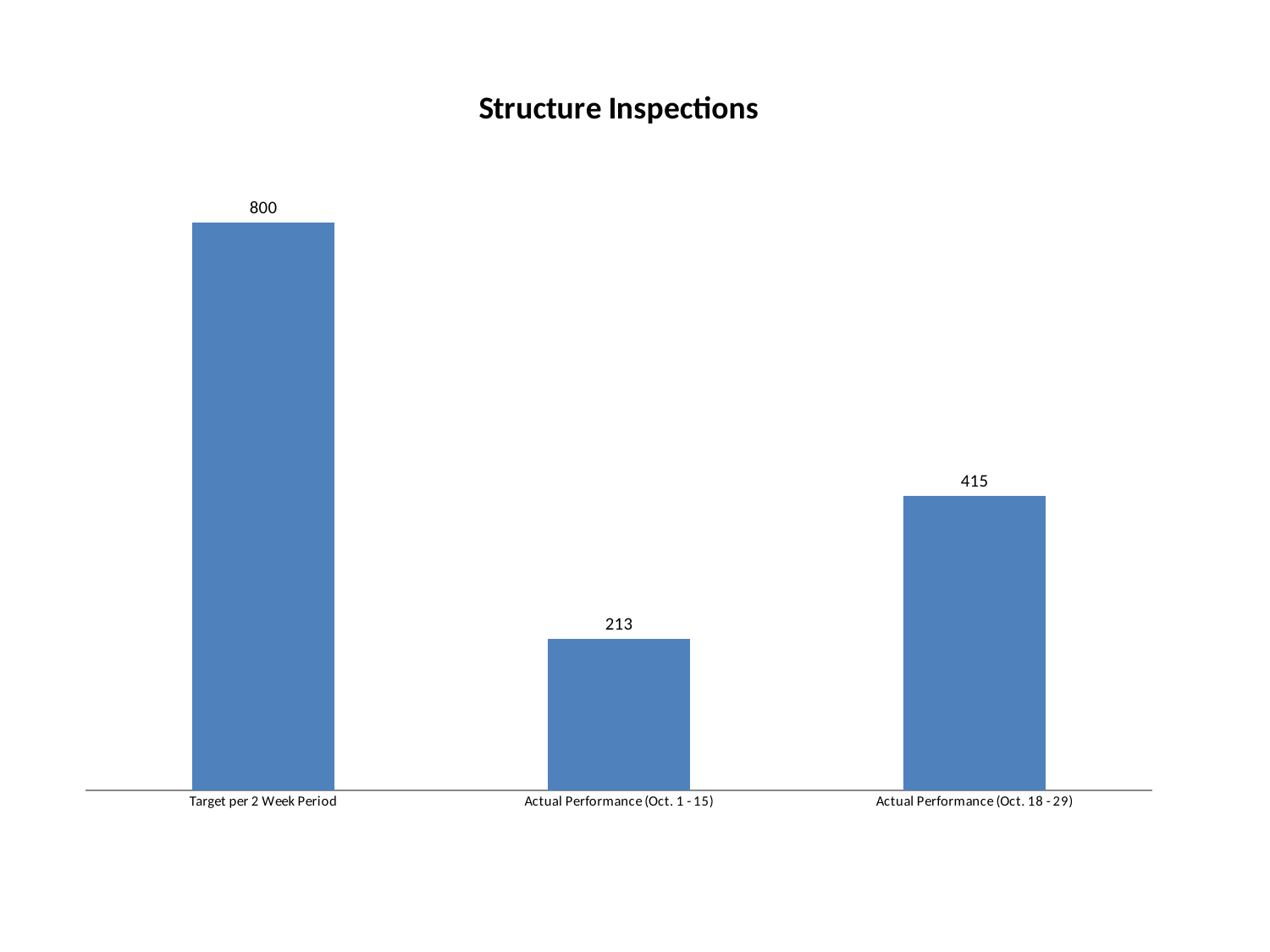
What kind of chart is shown on the slide? Bar chart What is the title of the chart? Structure Inspections What is the value for Target per 2 Week Period? 800 What is the difference between Actual Performance (Oct. 18 - 29) and Actual Performance (Oct. 1 - 15)? 202 What is the value for Actual Performance (Oct. 1 - 15)? 213 How many categories are shown in the chart? 3 Which category has the lowest value? Actual Performance (Oct. 1 - 15) What is the difference between the Target per 2 Week Period and Actual Performance (Oct. 18 - 29)? 385 Which is larger, Actual Performance (Oct. 1 - 15) or Actual Performance (Oct. 18 - 29)? Actual Performance (Oct. 18 - 29) What is the total of the two Actual Performance values? 628 Which category has the highest value? Target per 2 Week Period What is the value for Actual Performance (Oct. 18 - 29)? 415